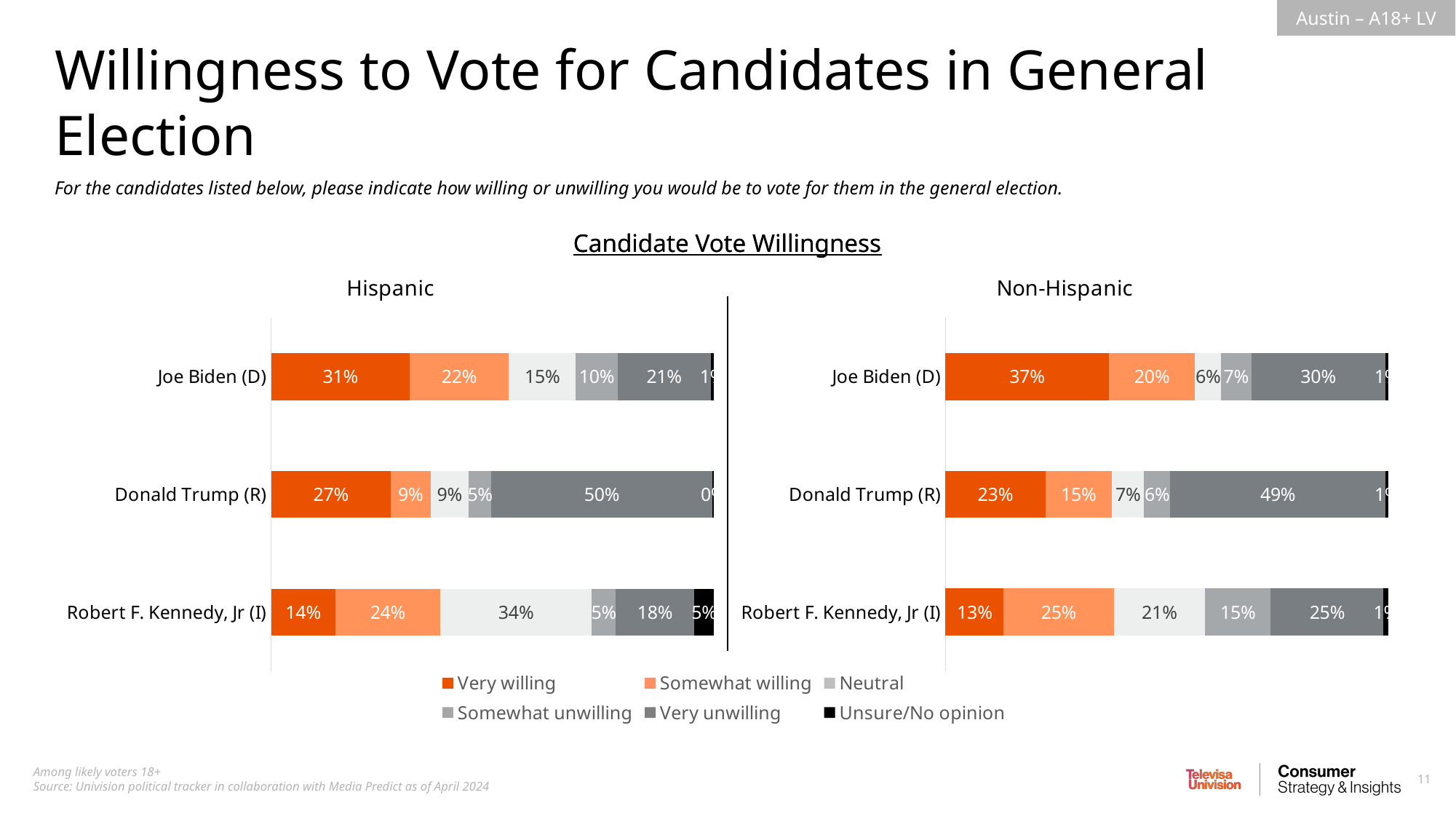
In the Non-Hispanic chart, what percentage of respondents are very unwilling to vote for Donald Trump (R)? 49% In the Non-Hispanic chart, is the Very willing percentage larger for Joe Biden (D) or Donald Trump (R)? Joe Biden (D) In the Hispanic chart, which candidate has the highest Very unwilling percentage? Donald Trump (R) In the Hispanic chart, what percentage of respondents are very willing to vote for Joe Biden (D)? 31% What type of chart is used for the Non-Hispanic data? Stacked bar chart How many candidates are shown in the Hispanic chart? 3 In the Non-Hispanic chart, what is the Somewhat willing value for Robert F. Kennedy, Jr (I)? 25% In the Hispanic chart, what is the Neutral value for Robert F. Kennedy, Jr (I)? 34% How many series does the legend list? 6 In the Hispanic chart, what is the difference between the Very willing percentages for Joe Biden (D) and Donald Trump (R)? 4% What is the title shown above the two charts? Candidate Vote Willingness In the Non-Hispanic chart, which candidate has the lowest Very willing percentage? Robert F. Kennedy, Jr (I)